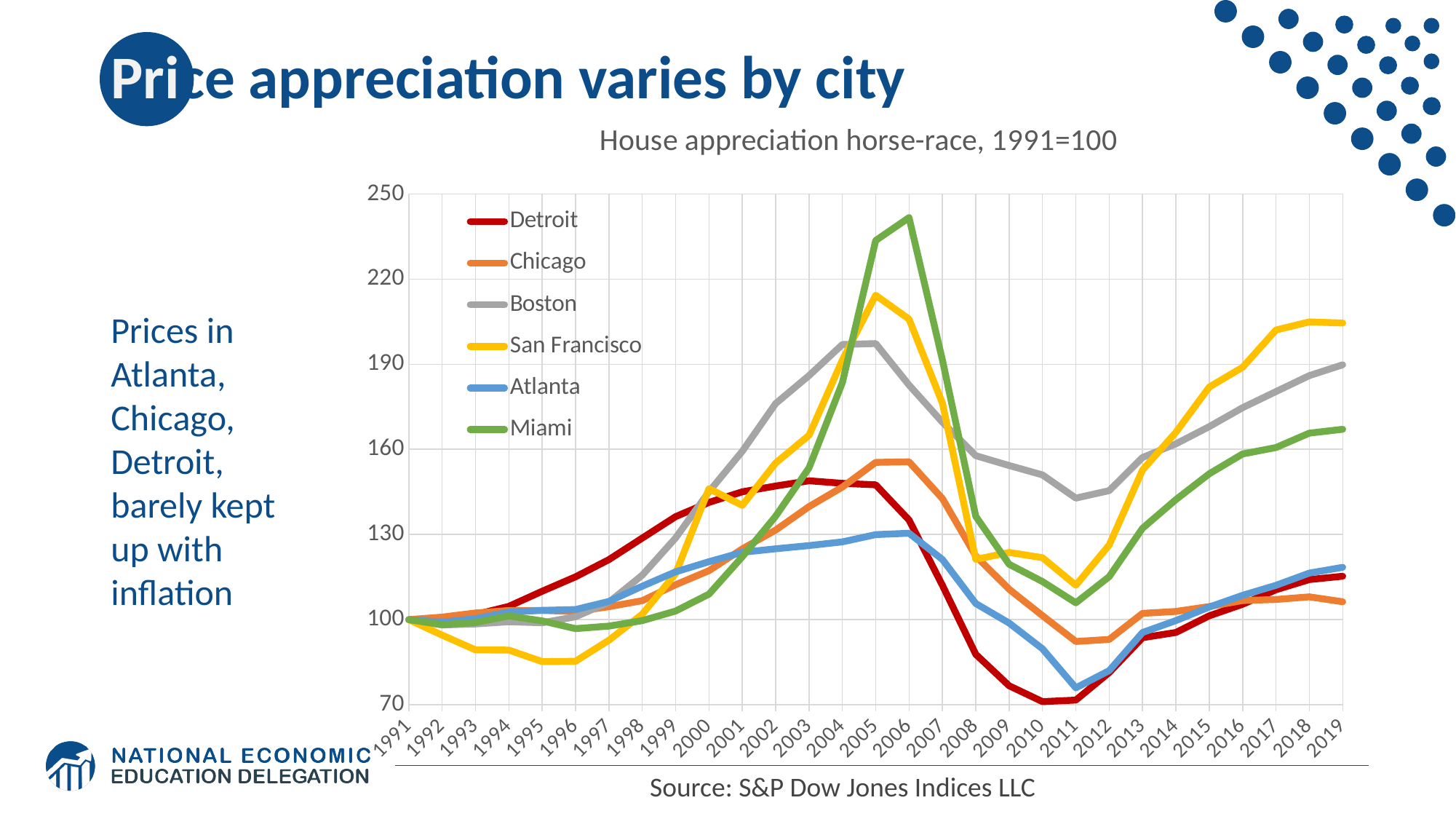
What kind of chart is shown on the slide? line chart Is the value for Detroit in 2010 greater or less than 100? less Does the Detroit line rise or fall from 2006 to 2010? fall Which city has the lowest index value in 2010? Detroit Which city has the highest index value in 2019? San Francisco Which is larger in 2019, the value for Boston or the value for Chicago? Boston How many cities does the legend list? 6 How many years are plotted along the x axis? 29 What is the index value for Detroit in 1991? 100 What is the title of the chart? House appreciation horse-race, 1991=100 Which city has the highest index value in 2006? Miami Is the value for Miami in 2006 greater or less than 220? greater